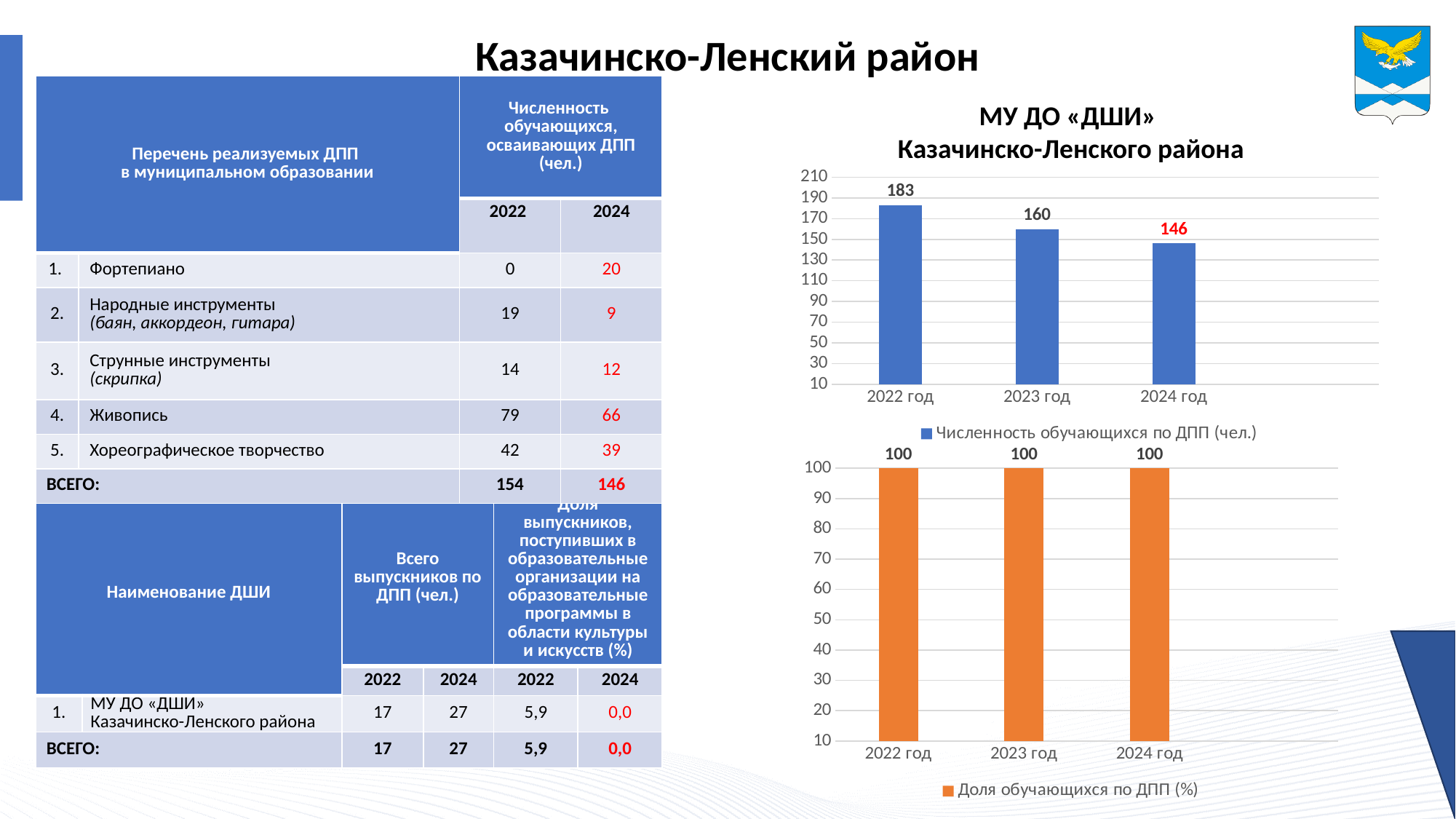
In the top chart (blue bars), what is the value for 2022 год? 183 In the top chart (blue bars), which year has the lowest value? 2024 год In the top chart (blue bars), do the values rise or fall from 2022 год to 2024 год? fall In the top chart (blue bars), what is the difference between the values for 2022 год and 2024 год? 37 In the bottom chart (orange bars), what is the legend entry? Доля обучающихся по ДПП (%) What type of chart is the bottom chart (orange bars)? bar chart In the top chart (blue bars), which year has the highest value? 2022 год In the top chart (blue bars), how many bars are plotted? 3 In the top chart (blue bars), what is the value for 2024 год? 146 In the top chart (blue bars), what is the value for 2023 год? 160 In the bottom chart (orange bars), what is the value for 2023 год? 100 What is the title of the top chart (blue bars)? МУ ДО «ДШИ» Казачинско-Ленского района